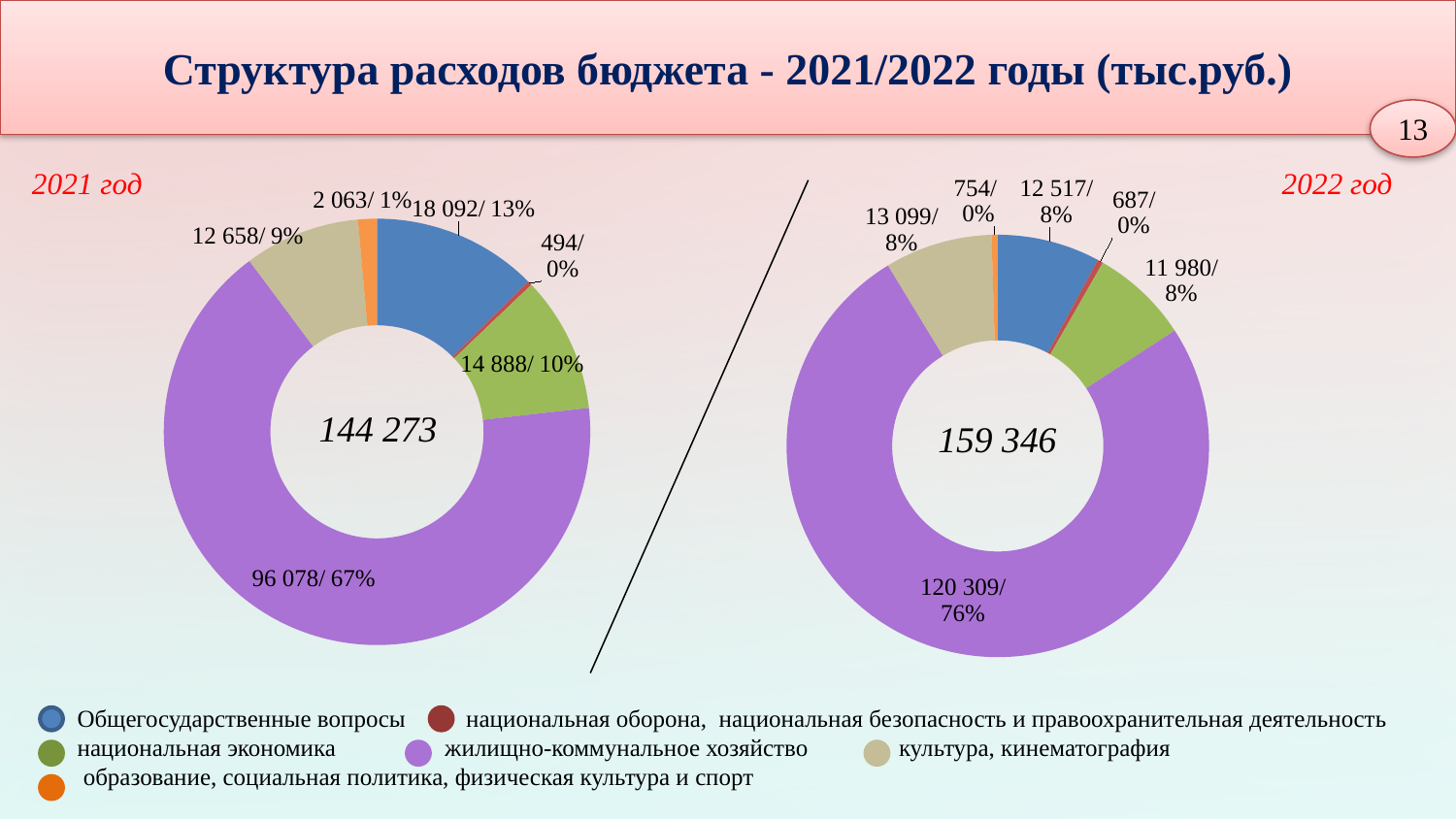
Which is larger: Общегосударственные вопросы in the 2021 год chart or in the 2022 год chart? 2021 год What is the difference between the жилищно-коммунальное хозяйство values in the 2022 год and 2021 год charts? 24 231 In the 2022 год chart, which category has the largest share? жилищно-коммунальное хозяйство In the 2022 год chart, what value is shown for Общегосударственные вопросы? 12 517/ 8% In the 2021 год chart, what value is shown for национальная экономика? 14 888/ 10% What is the total shown in the centre of the 2021 год chart? 144 273 What share of the 2021 год chart does жилищно-коммунальное хозяйство take? 67% In the 2022 год chart, what value is shown for культура, кинематография? 13 099/ 8% In the 2021 год chart, what value is shown for жилищно-коммунальное хозяйство? 96 078/ 67% What is the total shown in the centre of the 2022 год chart? 159 346 How many categories does the legend list? 6 In the 2021 год chart, which category has the smallest value? национальная оборона, национальная безопасность и правоохранительная деятельность